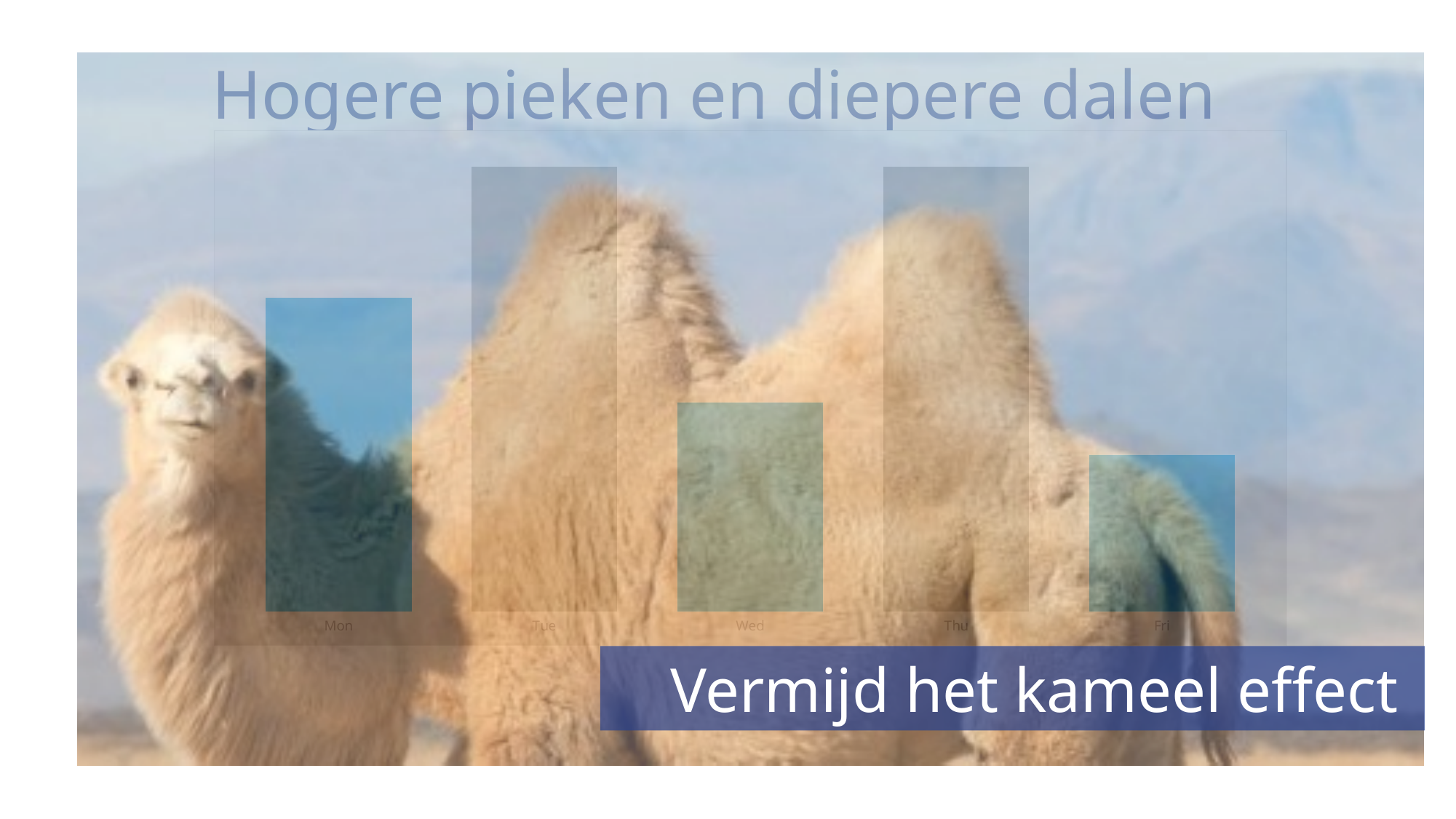
Which bar is taller, Tue or Wed? Tue What kind of chart is shown on the slide? bar chart Which bar is taller, Thu or Fri? Thu What is the title shown above the chart? Hogere pieken en diepere dalen Which bar is taller, Tue or Mon? Tue Which category has the lowest bar in the chart? Fri How many categories are shown on the x axis of the chart? 5 What are the category labels on the x axis of the chart, from left to right? Mon, Tue, Wed, Thu, Fri